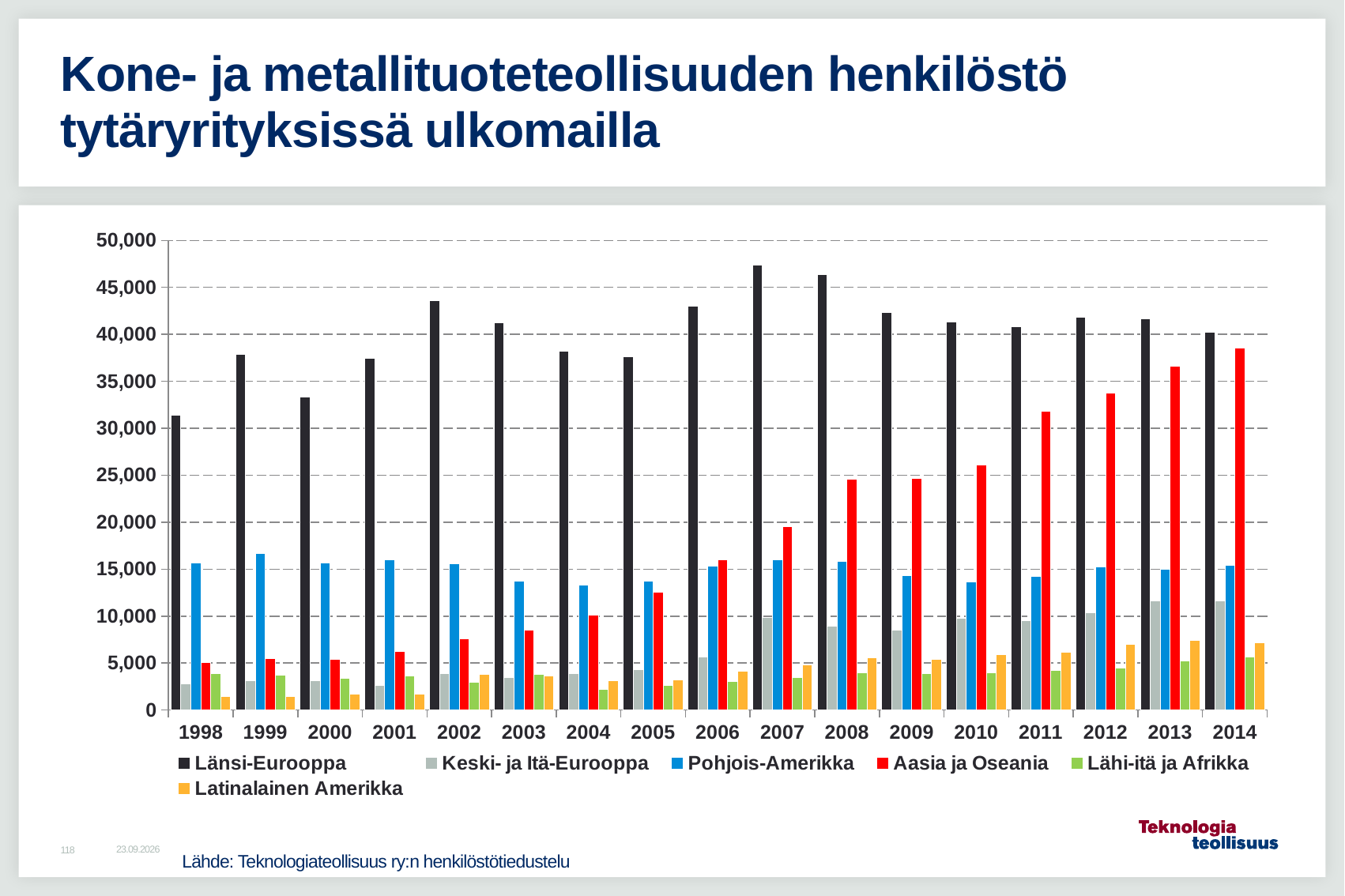
Which is larger in 2014, Länsi-Eurooppa or Aasia ja Oseania? Länsi-Eurooppa How many series does the legend list? 6 Which is larger in 2008, Aasia ja Oseania or Pohjois-Amerikka? Aasia ja Oseania How many years are shown on the x axis? 17 Is the value for Aasia ja Oseania in 1998 greater or less than 10,000? less Is the value for Keski- ja Itä-Eurooppa in 2013 greater or less than 10,000? greater What kind of chart is shown on the slide? bar chart In which year is the value for Aasia ja Oseania highest? 2014 In which year is the value for Länsi-Eurooppa lowest? 1998 In which year is the value for Länsi-Eurooppa highest? 2007 Do the values for Aasia ja Oseania generally rise or fall from 1998 to 2014? rise Is the value for Länsi-Eurooppa in 2007 greater or less than 45,000? greater